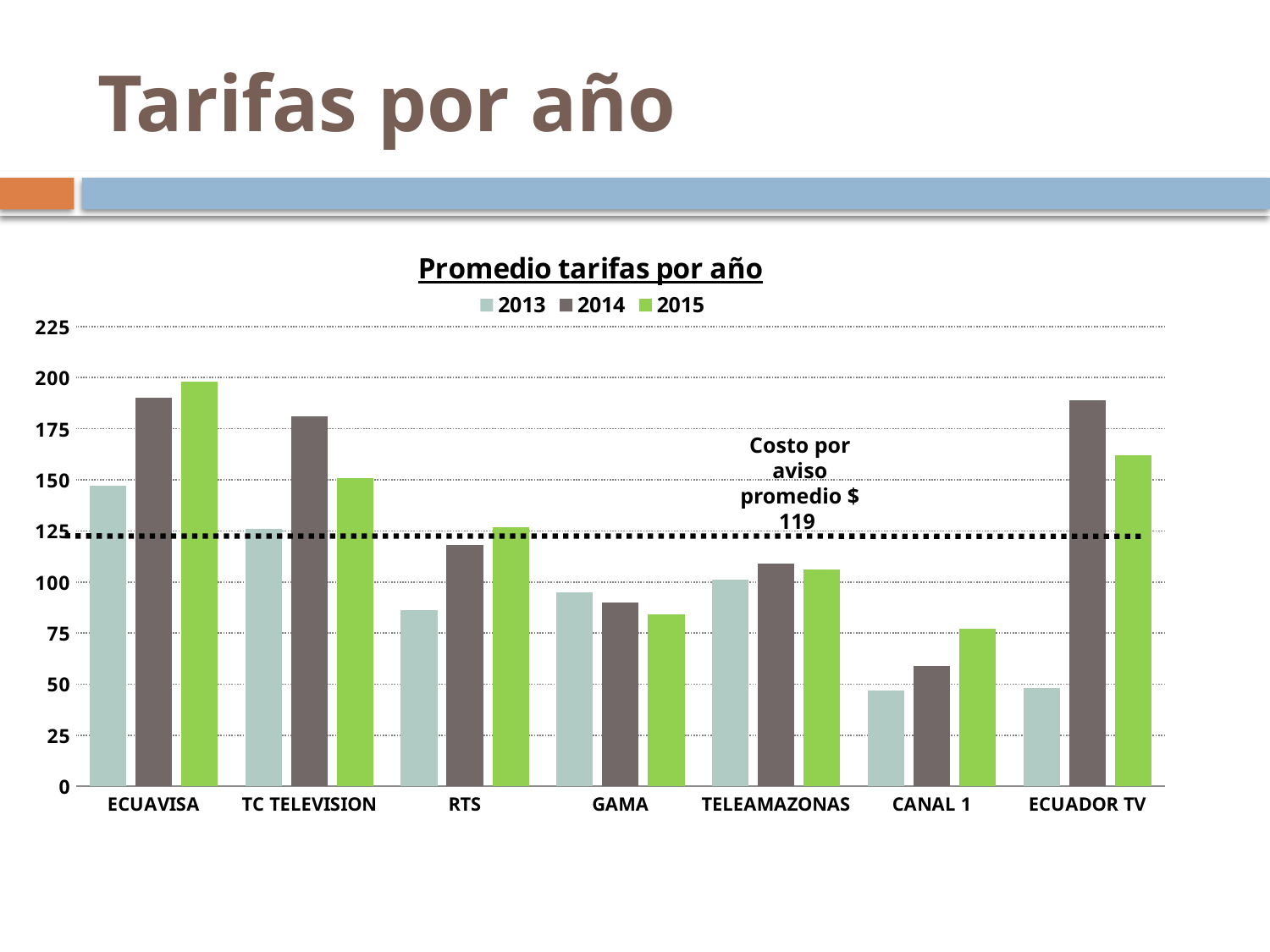
Which is larger, the 2014 value for TC TELEVISION or the 2014 value for RTS? TC TELEVISION What average cost per ad does the dotted horizontal line represent? $ 119 Is the 2013 value for RTS greater or less than 100? less What kind of chart is shown on the slide? bar chart How many series does the legend list? 3 Is the 2014 value for CANAL 1 greater or less than 50? greater Is the 2015 value for GAMA greater or less than 100? less For ECUADOR TV, which is larger, the 2014 value or the 2015 value? 2014 Do the values for CANAL 1 rise or fall from 2013 to 2015? rise How many TV channels are shown on the x axis? 7 Which channel has the highest 2015 value? ECUAVISA Which channel has the lowest 2014 value? CANAL 1